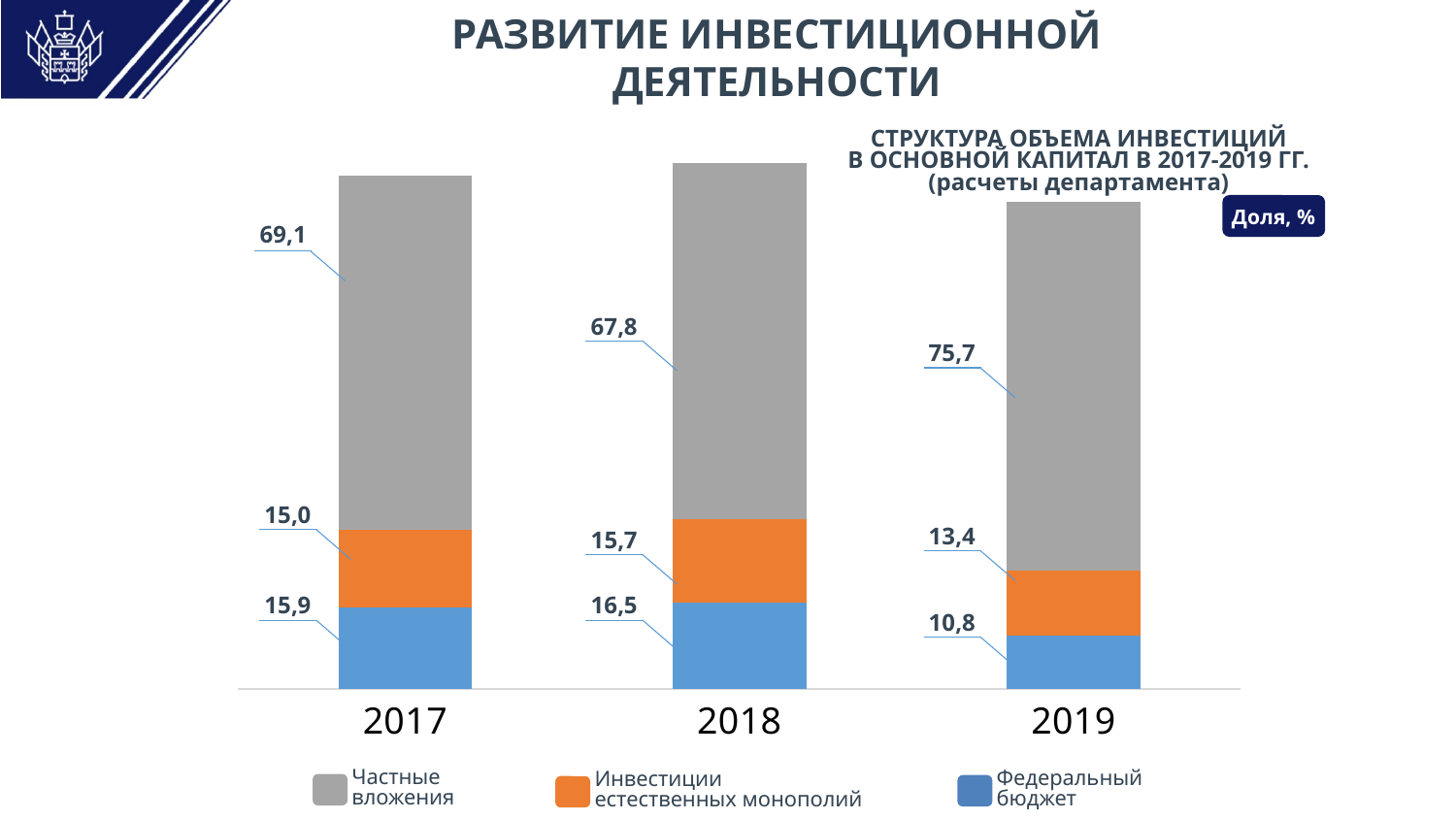
In which year is the share of Частные вложения the highest? 2019 What kind of chart is shown on the slide? Stacked bar chart What is the value for Инвестиции естественных монополий in 2018? 15,7 Which is larger: the Федеральный бюджет share in 2018 or in 2019? 2018 What is the difference between the Частные вложения share in 2019 and in 2018? 7,9 What is the value for Федеральный бюджет in 2017? 15,9 Which colour represents Федеральный бюджет in the chart? Blue How many series does the legend list? 3 Does the share of Инвестиции естественных монополий rise or fall from 2018 to 2019? Fall In which year is the share of Федеральный бюджет the lowest? 2019 What share do private investments (Частные вложения) have in 2019? 75,7 How many years are shown on the x axis? 3